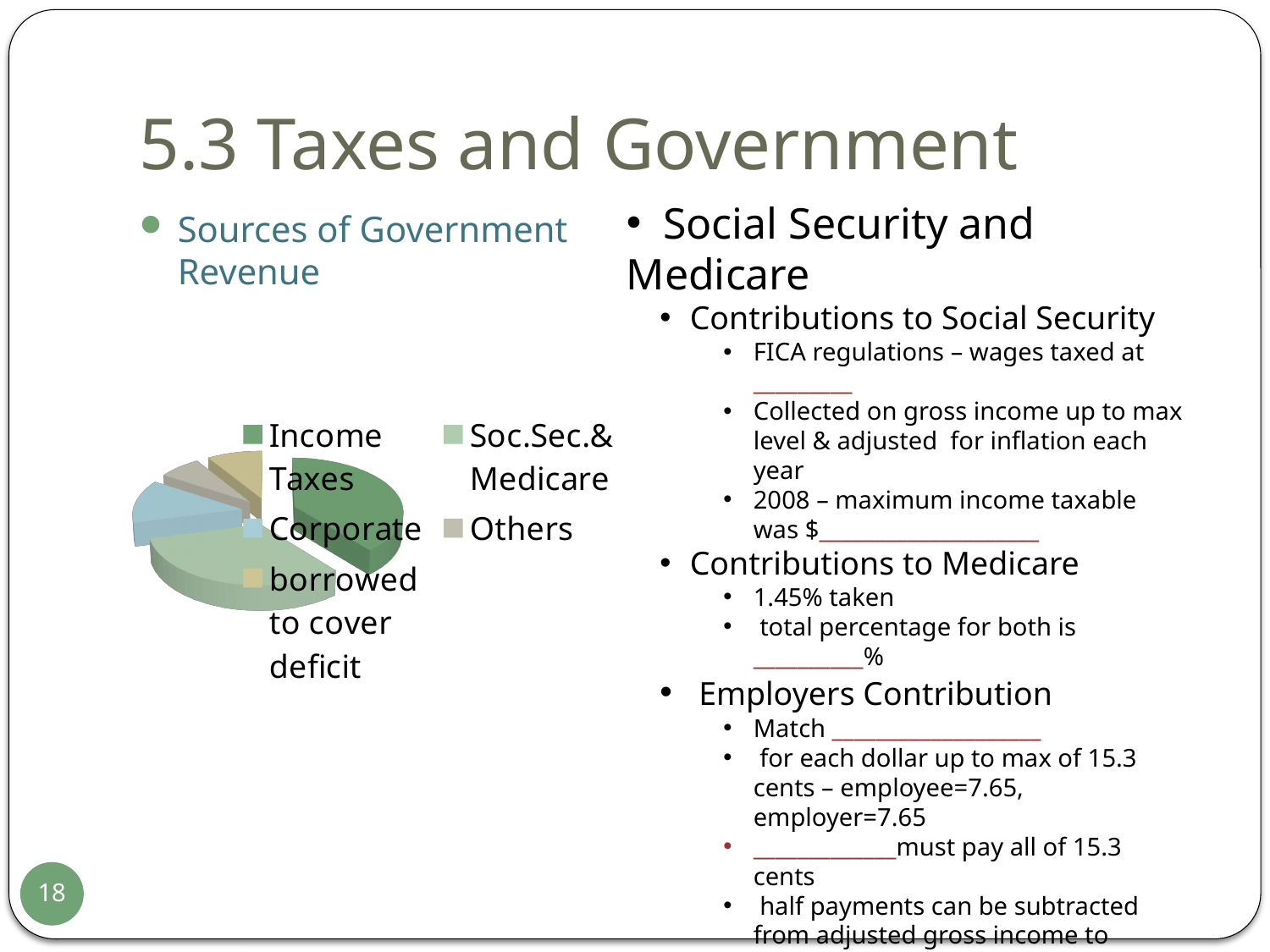
Which is larger in the pie chart, Corporate or Others? Corporate Which is larger in the pie chart, Income Taxes or Corporate? Income Taxes How many categories does the pie chart's legend list? 5 What heading appears above the pie chart? Sources of Government Revenue Which legend category is shown in dark green in the pie chart? Income Taxes Which is larger in the pie chart, Income Taxes or borrowed to cover deficit? Income Taxes What kind of chart is shown on the slide? pie chart